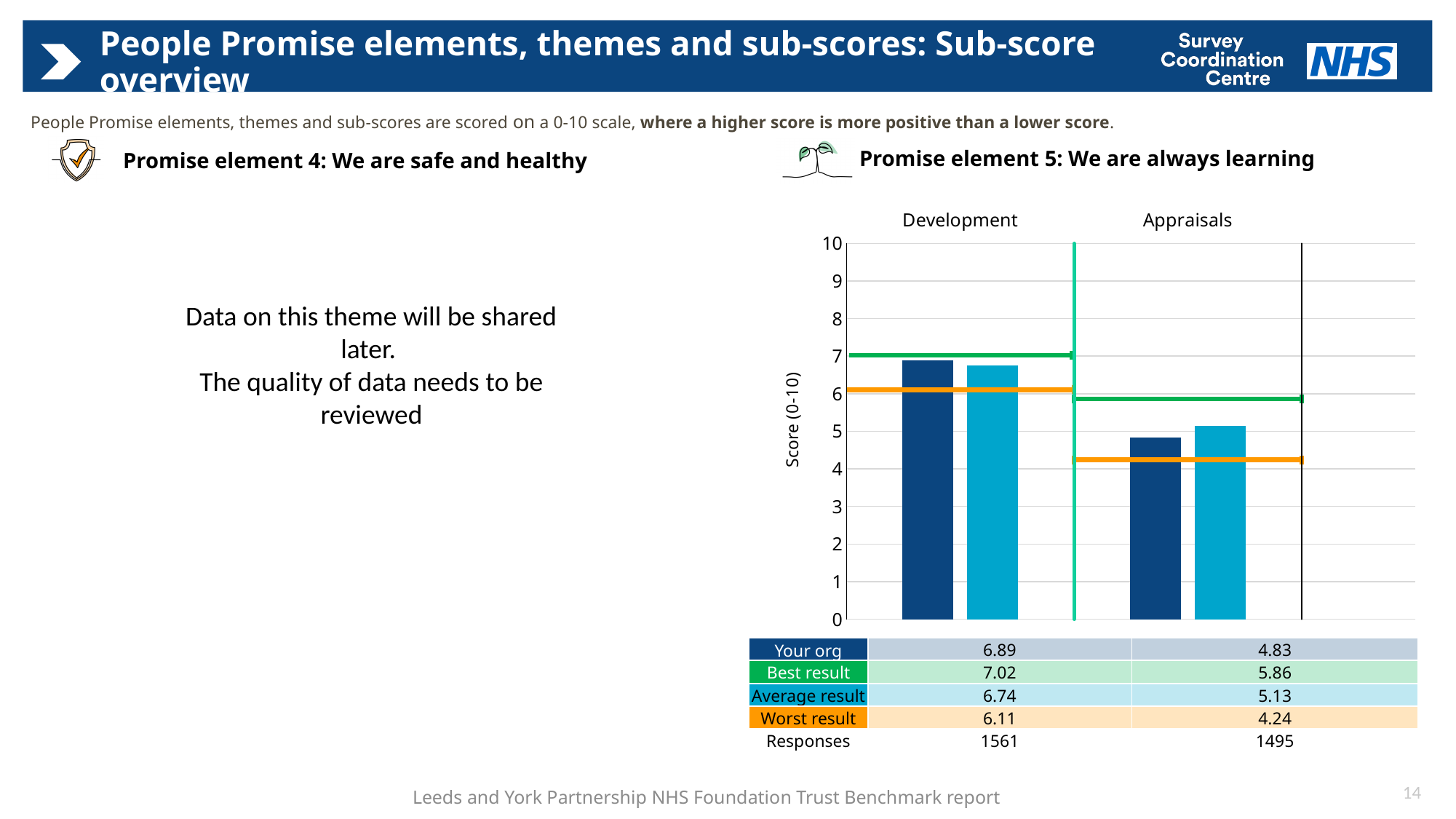
Which sub-score has the higher 'Your org' value, Development or Appraisals? Development What is the Best result for Appraisals? 5.86 What is the Average result for Development? 6.74 What is the difference between the 'Your org' score and the Average result for Appraisals? 0.30 What is the Worst result for Appraisals? 4.24 What is the difference between the Best result and the Worst result for Development? 0.91 What is the 'Your org' score for Development? 6.89 Is the 'Your org' value for Appraisals greater or less than 5? less What is the 'Your org' score for Appraisals? 4.83 How many sub-score categories are plotted in the chart? 2 What type of chart is used to show the Promise element 5 sub-scores? Bar chart How many responses were recorded for Development? 1561